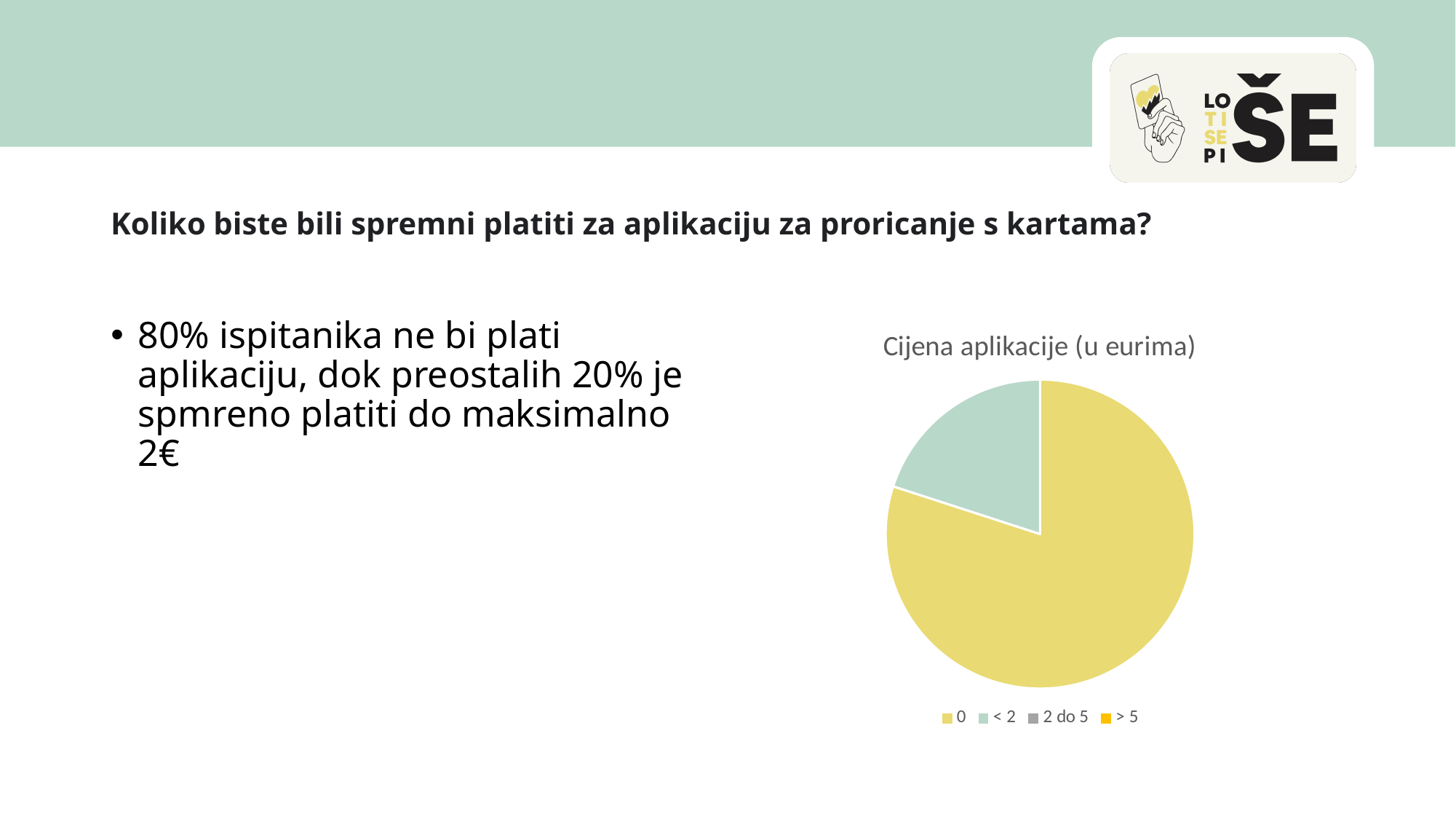
Which colour represents the "0" category in the pie chart? yellow How many slices are visible in the pie chart? 2 Which slice is larger, "0" or "< 2"? 0 What kind of chart is shown on the slide? pie chart Which category has the largest slice of the pie? 0 Is the slice for "0" greater or less than half of the pie? greater Is the slice for "< 2" greater or less than half of the pie? less Which of the visible slices is the smallest? < 2 What is the title of the chart? Cijena aplikacije (u eurima) How many categories does the chart legend list? 4